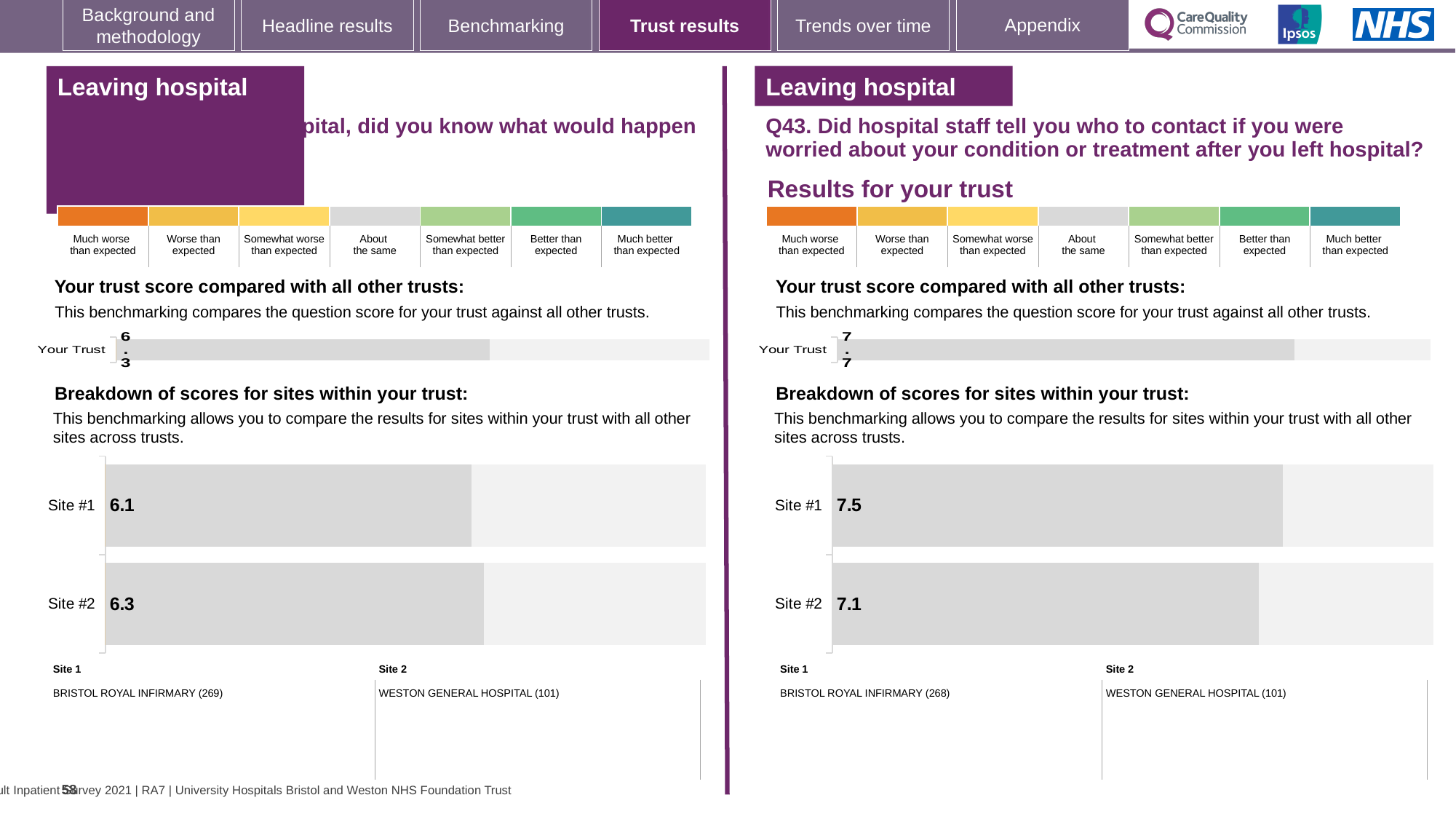
What type of chart is used for the site breakdown on the left-hand side of the slide? Bar chart In the Q43 site breakdown chart on the right-hand side, what is the difference between the Site #1 and Site #2 scores? 0.4 In the site breakdown chart on the left-hand side of the slide, what is the score for Site #1? 6.1 In the site breakdown chart on the left-hand side, which site has the lower score? Site #1 In the Q43 site breakdown chart on the right-hand side of the slide, what is the score for Site #2? 7.1 In the site breakdown chart on the left-hand side of the slide, what is the score for Site #2? 6.3 In the site breakdown chart on the left-hand side, what is the difference between the Site #2 and Site #1 scores? 0.2 In the Q43 site breakdown chart on the right-hand side, which site has the higher score? Site #1 In the 'Your trust score compared with all other trusts' chart on the left-hand side of the slide, what is the score for Your Trust? 6.3 How many sites are shown in the Q43 site breakdown chart on the right-hand side of the slide? 2 In the 'Your trust score compared with all other trusts' chart on the right-hand side (Q43), what is the score for Your Trust? 7.7 In the Q43 site breakdown chart on the right-hand side of the slide, what is the score for Site #1? 7.5